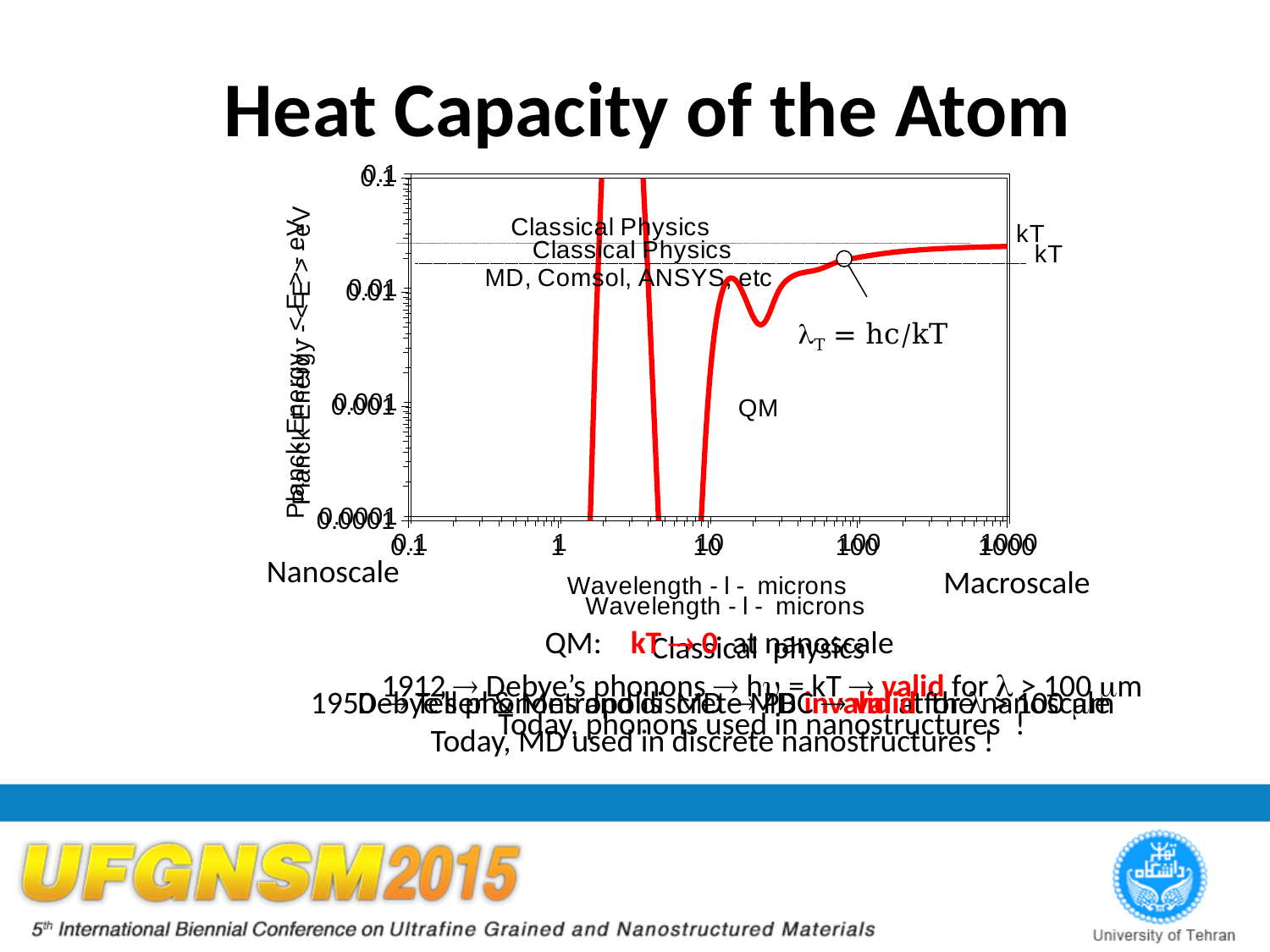
What is the lowest tick value shown on the x axis? 0.1 What is the lowest tick value shown on the y axis? 0.0001 How many labelled tick values are shown on the x axis? 5 What colour is the plotted curve on the chart? red Is the value of the curve at 100 microns greater or less than 0.01? greater What is the highest tick value shown on the x axis? 1000 Does the curve rise or fall as the wavelength increases from 100 to 1000 microns? rise What kind of chart is shown on the slide? line chart What is the label of the x axis of the chart? Wavelength - l - microns Is the value of the curve at 1000 microns greater or less than 0.01? greater What is the highest tick value shown on the y axis? 0.1